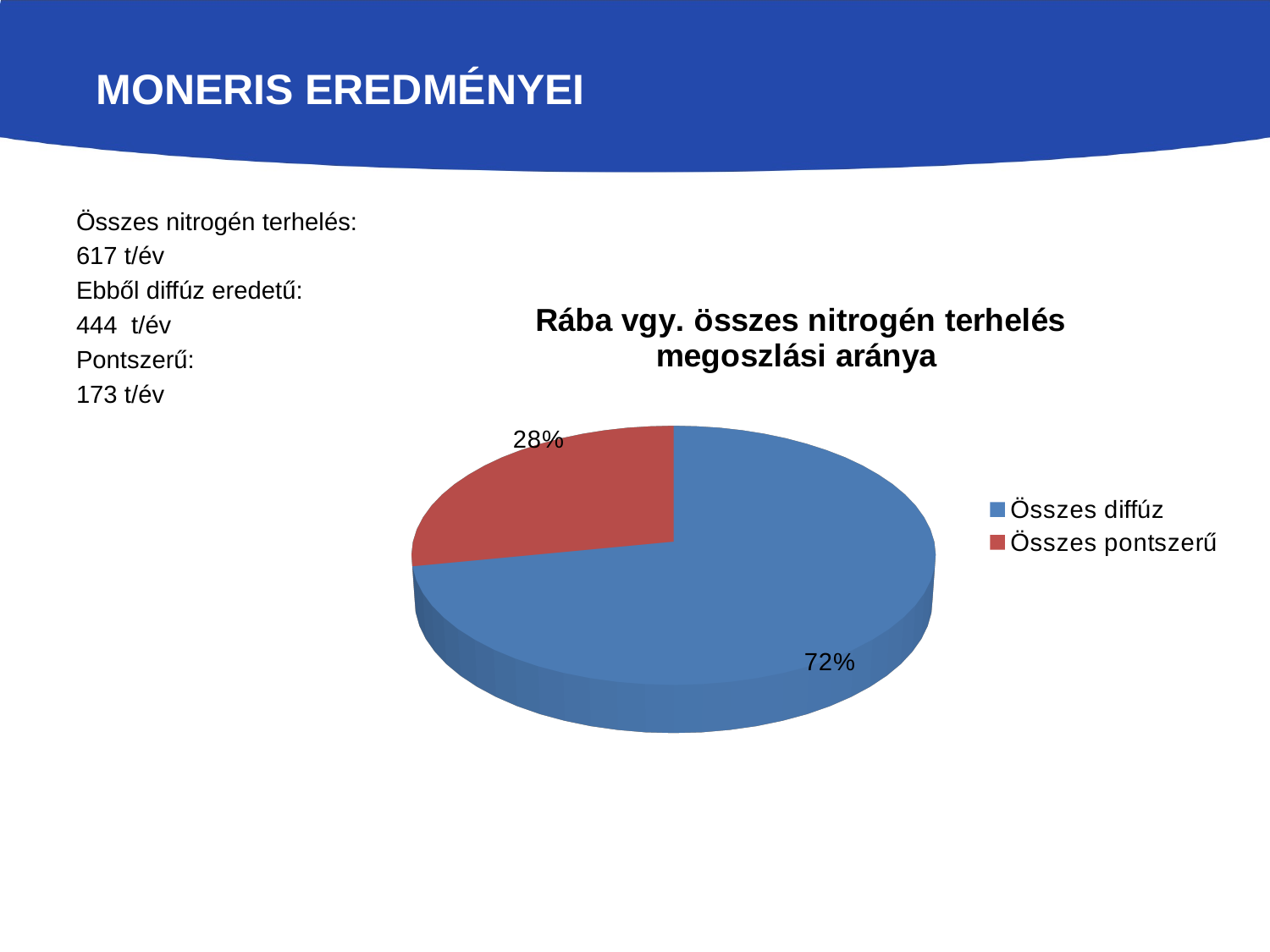
What is the title of the chart? Rába vgy. összes nitrogén terhelés megoszlási aránya What kind of chart is shown on the slide? Pie chart How many entries does the legend list? 2 How many slices does the pie chart have? 2 Which category has the largest slice of the pie? Összes diffúz What share of the pie does Összes pontszerű represent? 28% Which category has the smallest slice of the pie? Összes pontszerű What is the difference in percentage points between the Összes diffúz and Összes pontszerű slices? 44 What share of the pie does Összes diffúz represent? 72% What colour is the Összes pontszerű slice? Red Which is larger, the Összes diffúz slice or the Összes pontszerű slice? Összes diffúz